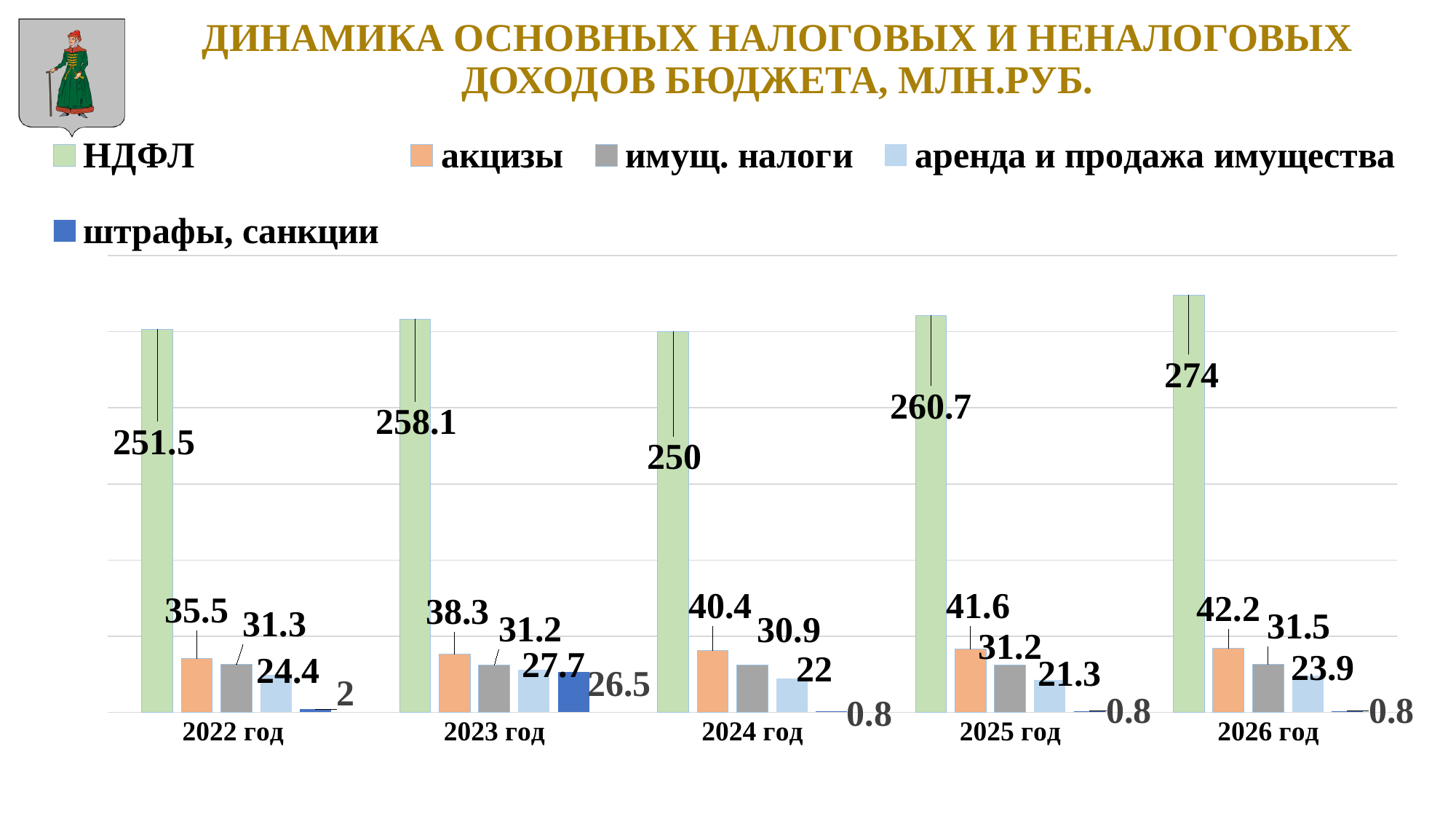
How many series does the legend list? 5 How many years are shown on the x axis? 5 Do the values for акцизы rise or fall from 2022 год to 2026 год? rise In which year is НДФЛ the highest? 2026 год Which is larger in 2024 год: акцизы or имущ. налоги? акцизы What is the difference between НДФЛ in 2026 год and 2022 год? 22.5 In which year is НДФЛ the lowest? 2024 год What is the value of акцизы for 2023 год? 38.3 What is the value of штрафы, санкции for 2023 год? 26.5 What kind of chart is shown on the slide? bar chart What is the value of аренда и продажа имущества for 2025 год? 21.3 What is the value of НДФЛ for 2026 год? 274